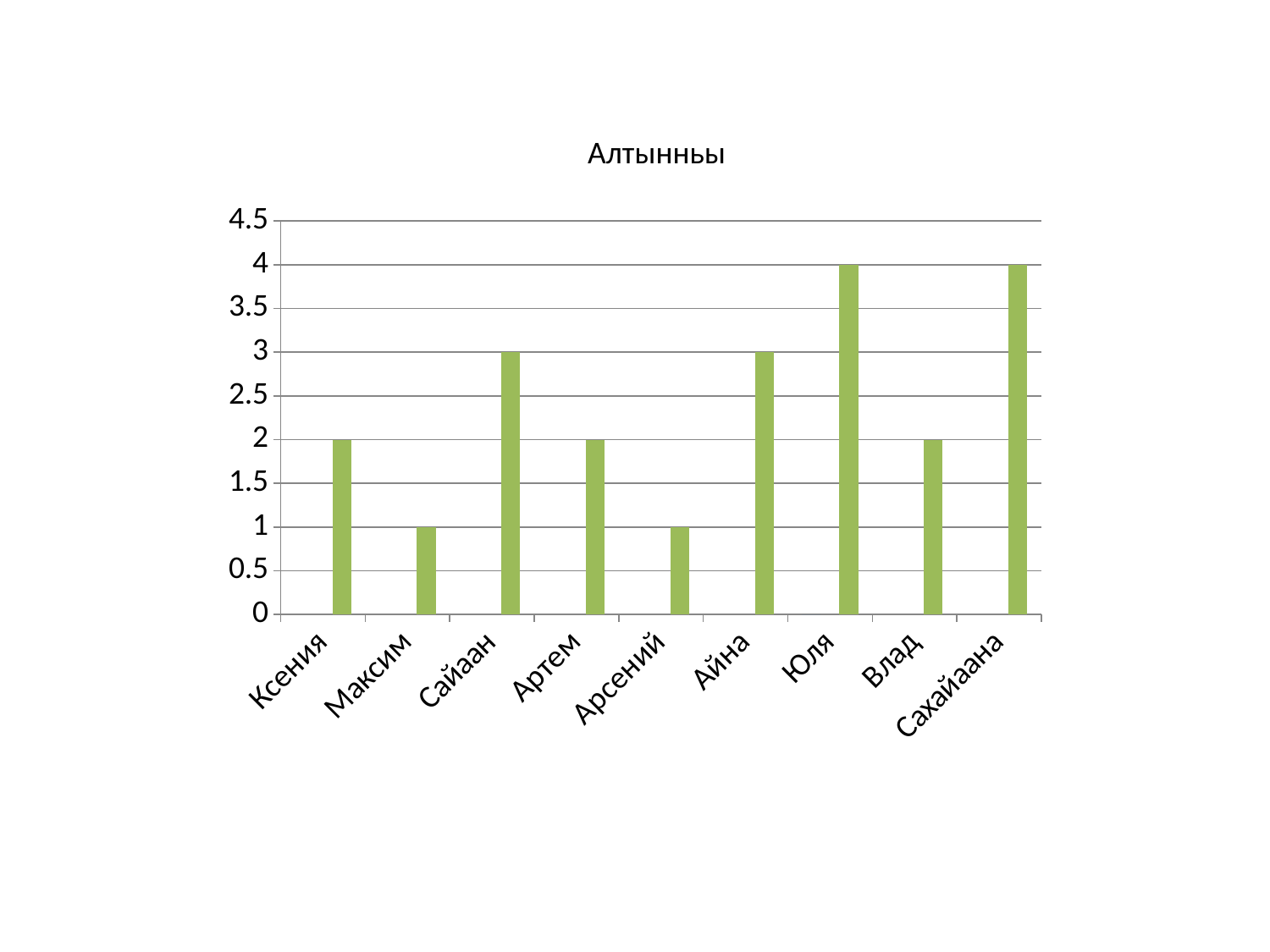
Is the value for Максим greater or less than 2? less Which two categories share the lowest value on the chart? Максим and Арсений Which is larger, the value for Айна or the value for Артем? Айна What is the title of the chart? Алтынньы What is the value for Юля? 4 Which two categories share the highest value on the chart? Юля and Сахайаана What is the value for Ксения? 2 What is the difference between the values for Сахайаана and Влад? 2 How many categories are shown on the x axis? 9 What is the value for Арсений? 1 What is the value for Сайаан? 3 What kind of chart is shown on the slide? bar chart